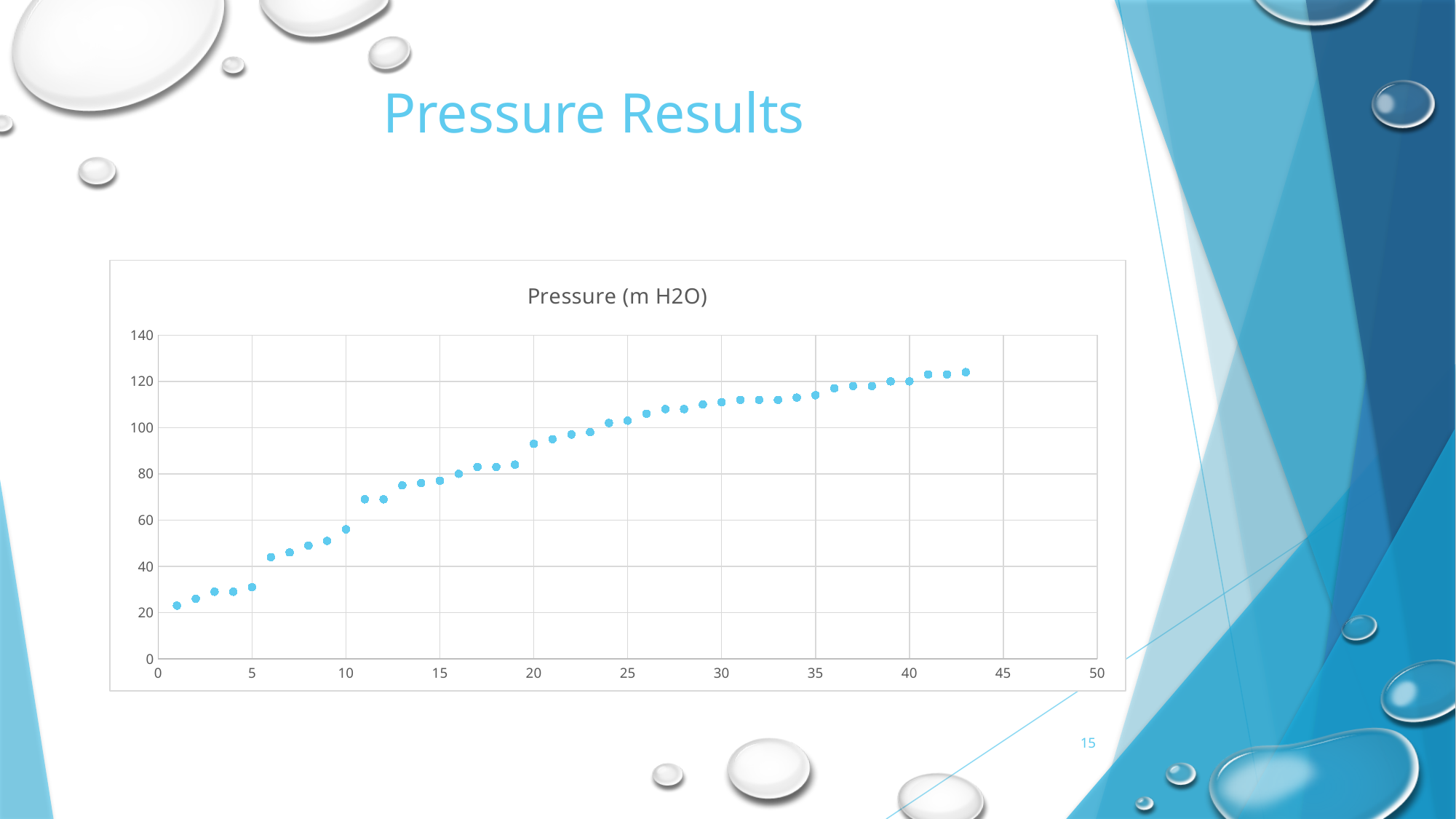
Is the value at x = 20 greater or less than 80? greater Is the value at x = 5 greater or less than 40? less Do the plotted values rise or fall as the x value increases? rise Is the value at x = 43 greater or less than 120? greater What kind of chart is shown on the slide? scatter chart At which x value is the plotted pressure lowest? 1 What is the title of the chart? Pressure (m H2O) Which has the larger pressure value, x = 10 or x = 20? x = 20 At which x value is the plotted pressure highest? 43